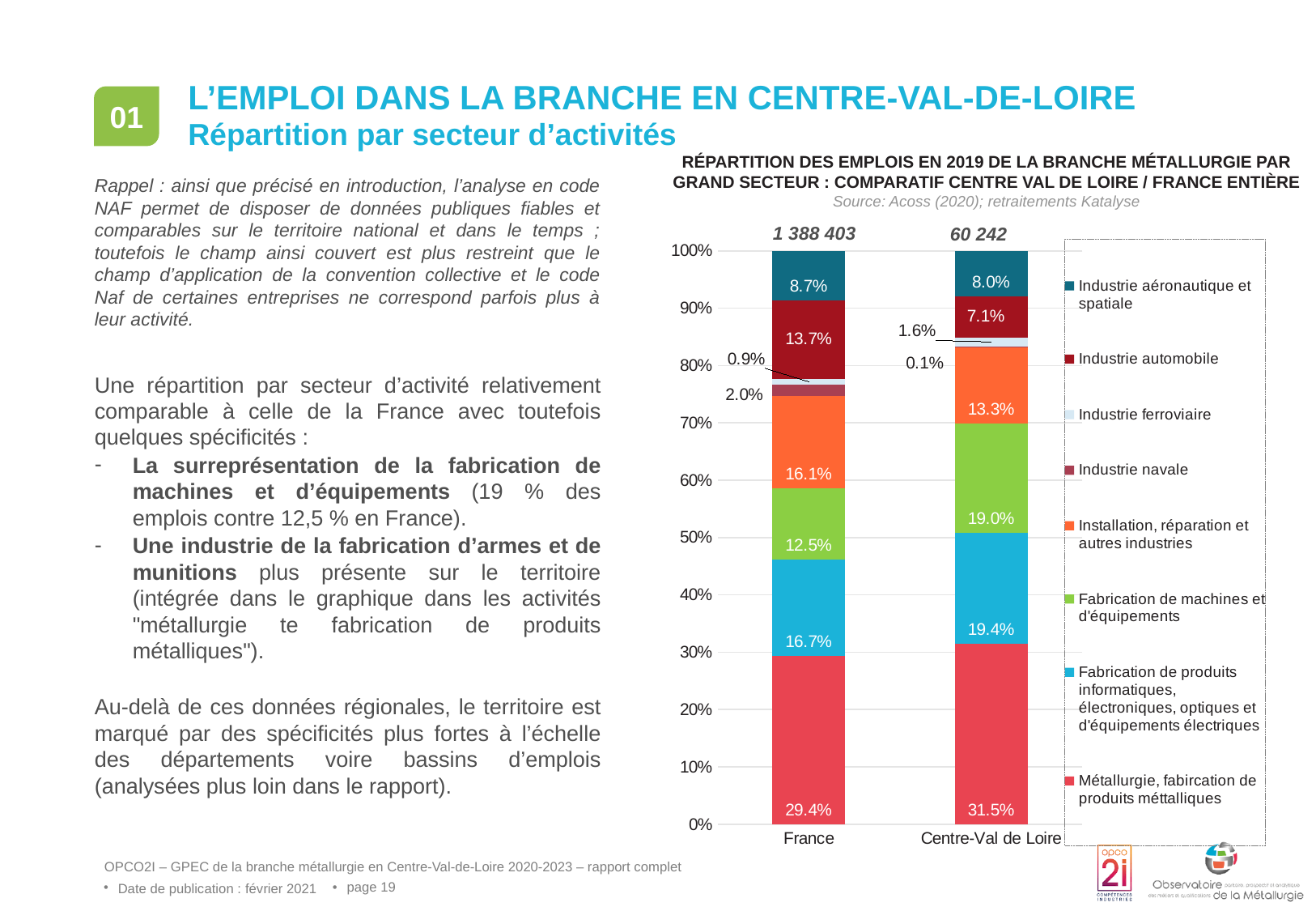
How many bars (categories) are shown on the x axis of the chart? 2 What share of employment does 'Métallurgie, fabrication de produits métalliques' represent in the France bar? 29.4% What is the value for 'Industrie aéronautique et spatiale' in the France bar? 8.7% By how many percentage points does the 'Fabrication de machines et d'équipements' share in Centre-Val de Loire exceed that of France? 6.5 percentage points How many series does the chart legend list? 8 Which has the larger share of 'Fabrication de produits informatiques, électroniques, optiques et d'équipements électriques', France or Centre-Val de Loire? Centre-Val de Loire Which has the larger share of 'Industrie automobile', France or Centre-Val de Loire? France What type of chart is shown on the slide? Stacked bar chart What is the value for 'Installation, réparation et autres industries' in the Centre-Val de Loire bar? 13.3% Which sector is the largest segment in the Centre-Val de Loire bar? Métallurgie, fabrication de produits métalliques What is the value for 'Fabrication de machines et d'équipements' in the Centre-Val de Loire bar? 19.0% What is the share of 'Industrie automobile' for Centre-Val de Loire? 7.1%